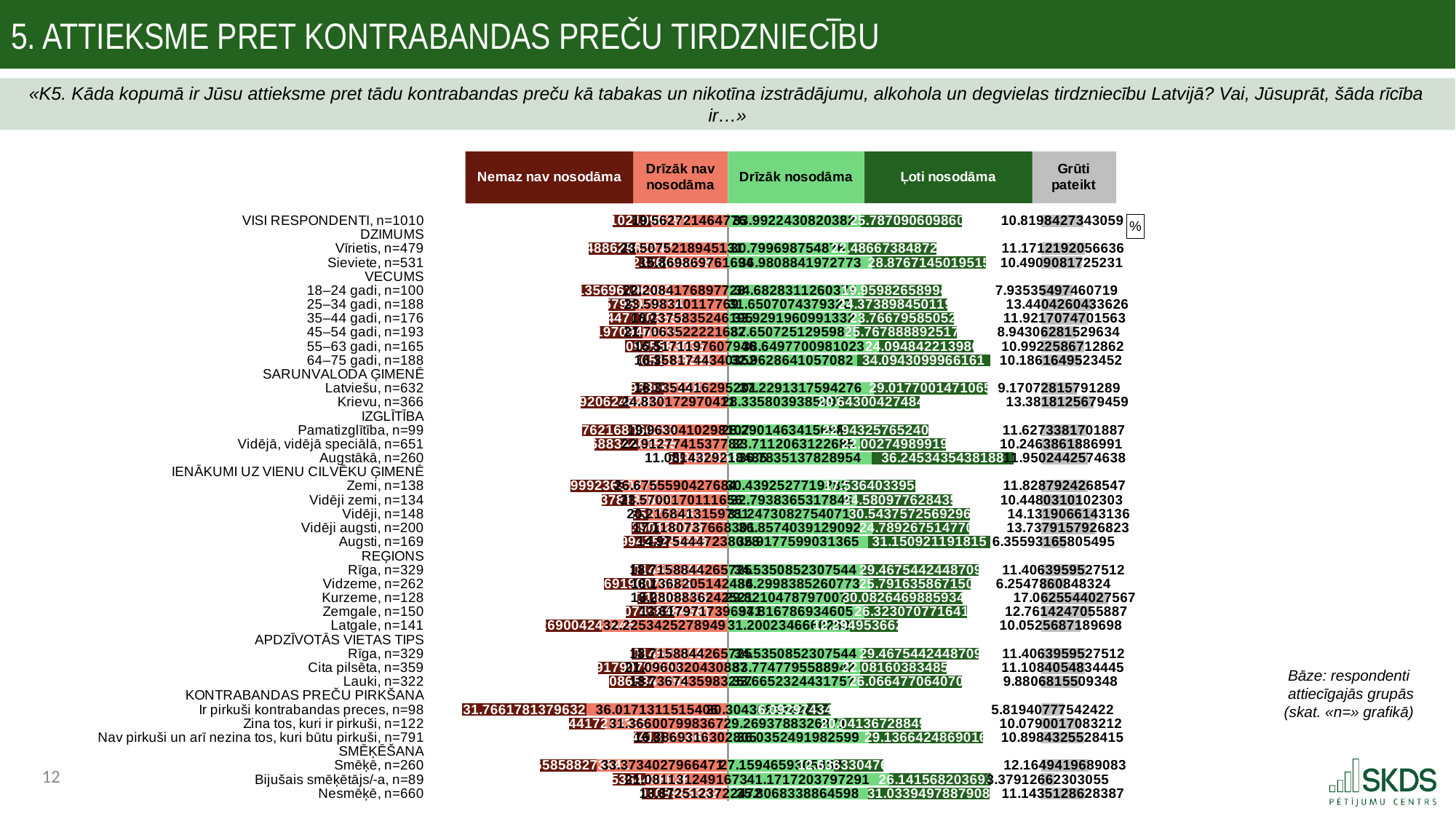
What kind of chart is shown on the slide? Stacked bar chart How many series does the legend list? 5 Among the REĢIONS groups, which has the highest 'Grūti pateikt' value? Kurzeme, n=128 What is the 'Grūti pateikt' value for VISI RESPONDENTI, n=1010? 10.8198427343059 What is the difference between the 'Grūti pateikt' values for Kurzeme, n=128 and Vidzeme, n=262? 10.8077683179243 What is the 'Grūti pateikt' value for Vidzeme, n=262? 6.2547860848324 Which has the larger 'Grūti pateikt' value: Krievu, n=366 or Latviešu, n=632? Krievu, n=366 Which series is shown in dark green in the legend? Ļoti nosodāma Among the REĢIONS groups, which has the lowest 'Grūti pateikt' value? Vidzeme, n=262 What is the 'Grūti pateikt' value for Kurzeme, n=128? 17.0625544027567 What is the 'Nemaz nav nosodāma' value for 'Ir pirkuši kontrabandas preces, n=98'? 31.7661781379632 Which series is shown in grey in the legend? Grūti pateikt